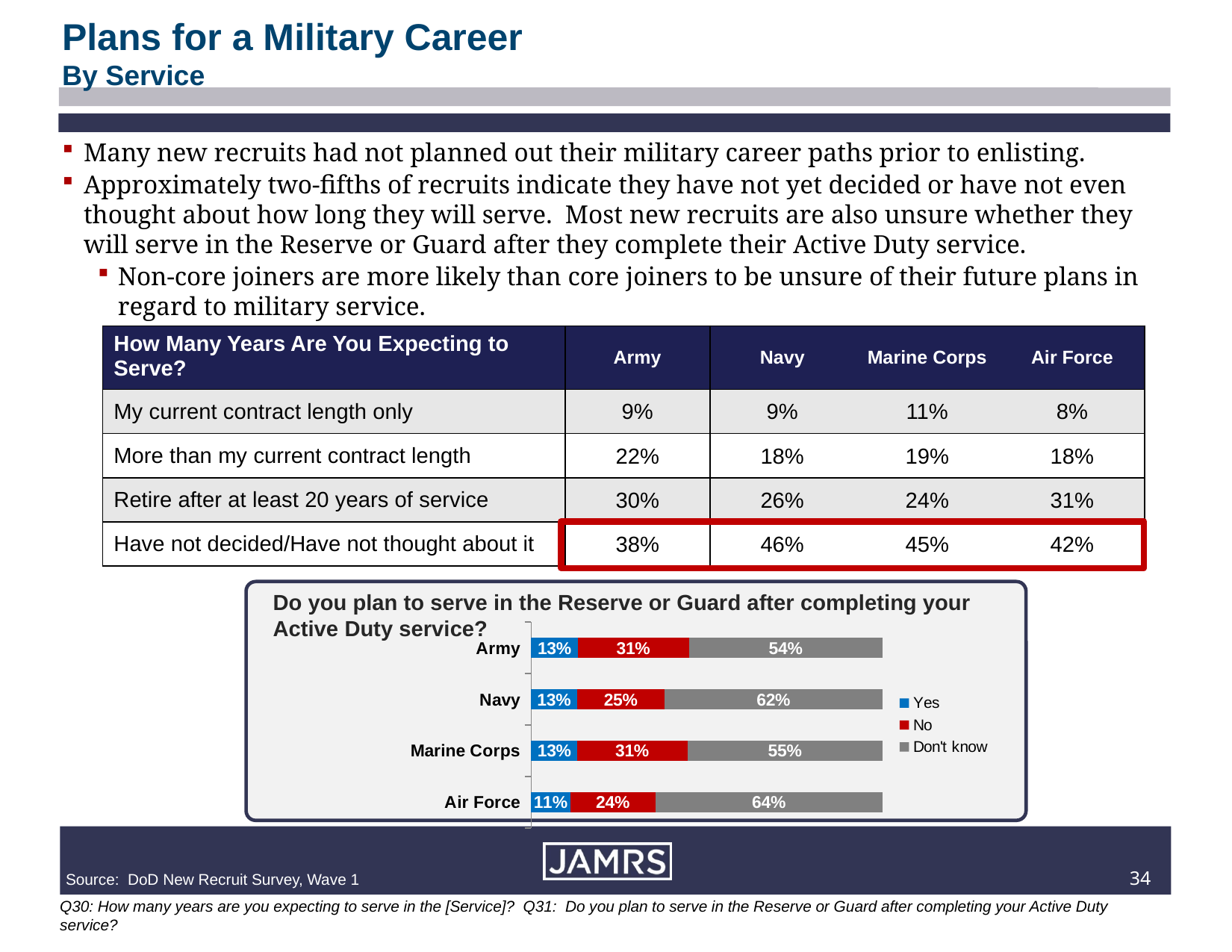
What is the 'Don't know' value for Navy in the chart? 62% What is the 'No' value for Marine Corps in the chart? 31% Which is larger in the chart: the 'No' value for Army or the 'No' value for Navy? Army What are the three legend entries in the chart? Yes, No, Don't know What is the difference between the 'Don't know' values for Air Force and Army in the chart? 10% What is the 'Yes' value for Air Force in the chart? 11% What is the total of the Navy bar in the chart (Yes + No + Don't know)? 100% What kind of chart is shown on the slide? Stacked bar chart How many series does the legend of the chart list? 3 Which service has the lowest 'No' value in the chart? Air Force Which service has the highest 'Don't know' value in the chart? Air Force How many services (categories) are shown in the chart? 4